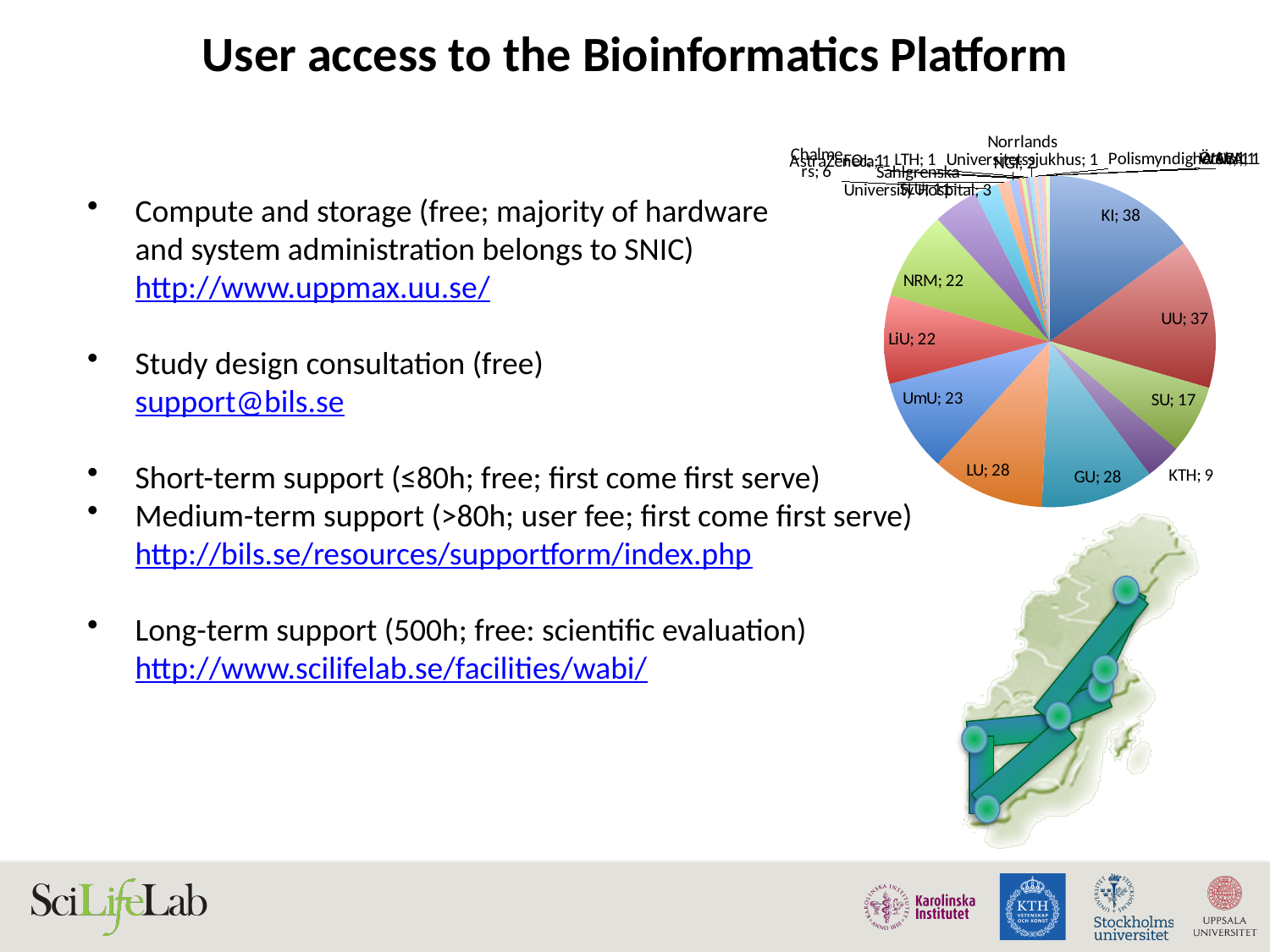
What is the value for Chalmers in the pie chart? 6 What is the value for KTH in the pie chart? 9 Which category has the largest slice in the pie chart? KI What is the difference between the values for UU and SU? 20 What is the value for KI in the pie chart? 38 What is the value for NRM in the pie chart? 22 What type of chart is shown on the slide? pie chart Which is larger, the value for GU or the value for KTH? GU What is the value for UU in the pie chart? 37 What is the value for SU in the pie chart? 17 What is the difference between the values for KI and UU? 1 What is the value for UmU in the pie chart? 23